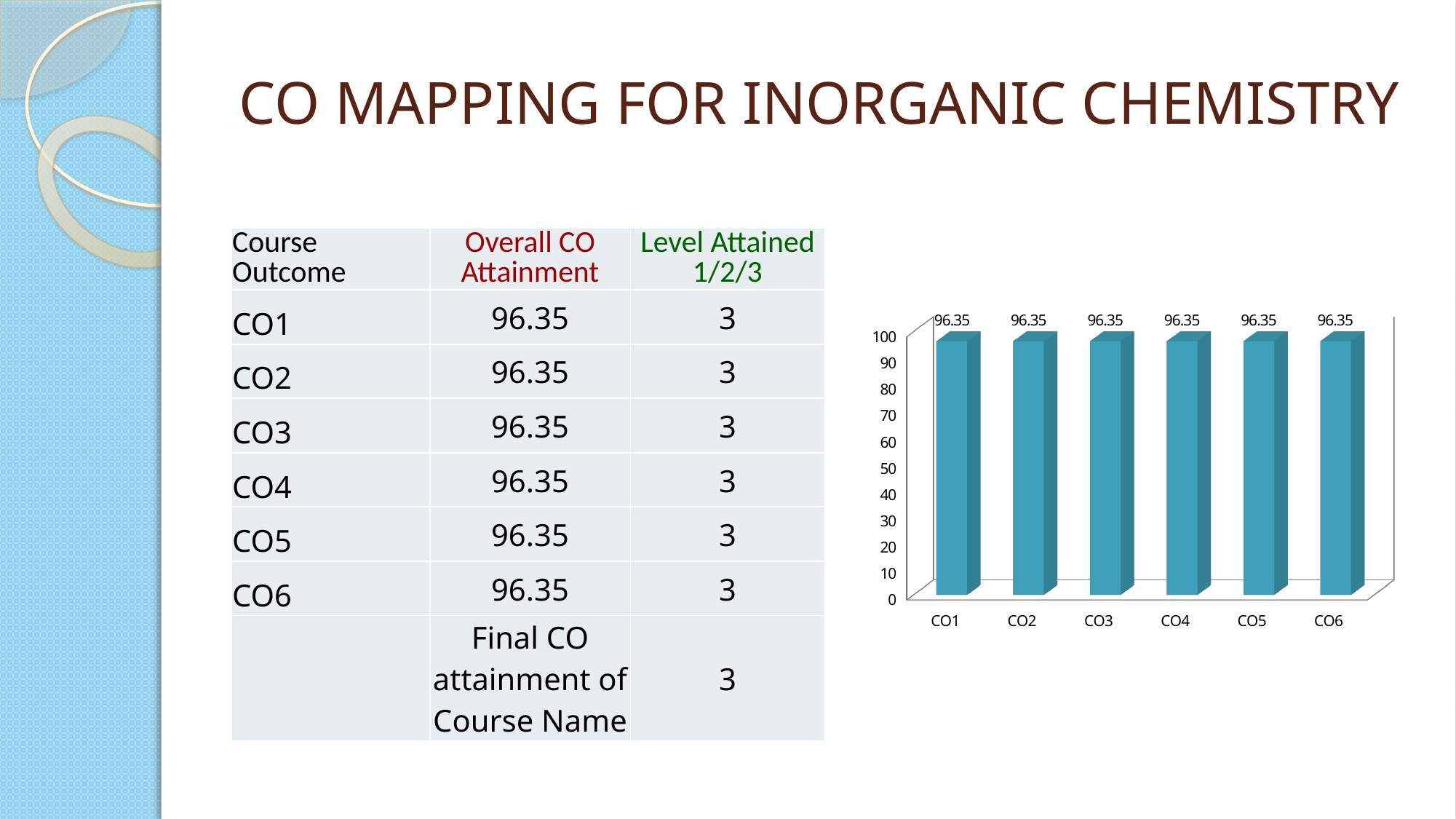
What is the difference between the values for CO2 and CO5 in the bar chart? 0 What is the value shown for CO6 in the bar chart? 96.35 What is the value shown for CO4 in the bar chart? 96.35 What is the value shown for CO1 in the bar chart? 96.35 Is the value for CO3 in the bar chart greater or less than 90? greater What kind of chart is shown on the slide? bar chart What is the highest tick value shown on the vertical axis of the bar chart? 100 What is the label of the first category on the x axis of the bar chart? CO1 How many categories are plotted on the x axis of the bar chart? 6 Is the value for CO5 in the bar chart greater or less than 100? less Do the values in the bar chart rise, fall, or stay the same from CO1 to CO6? stay the same